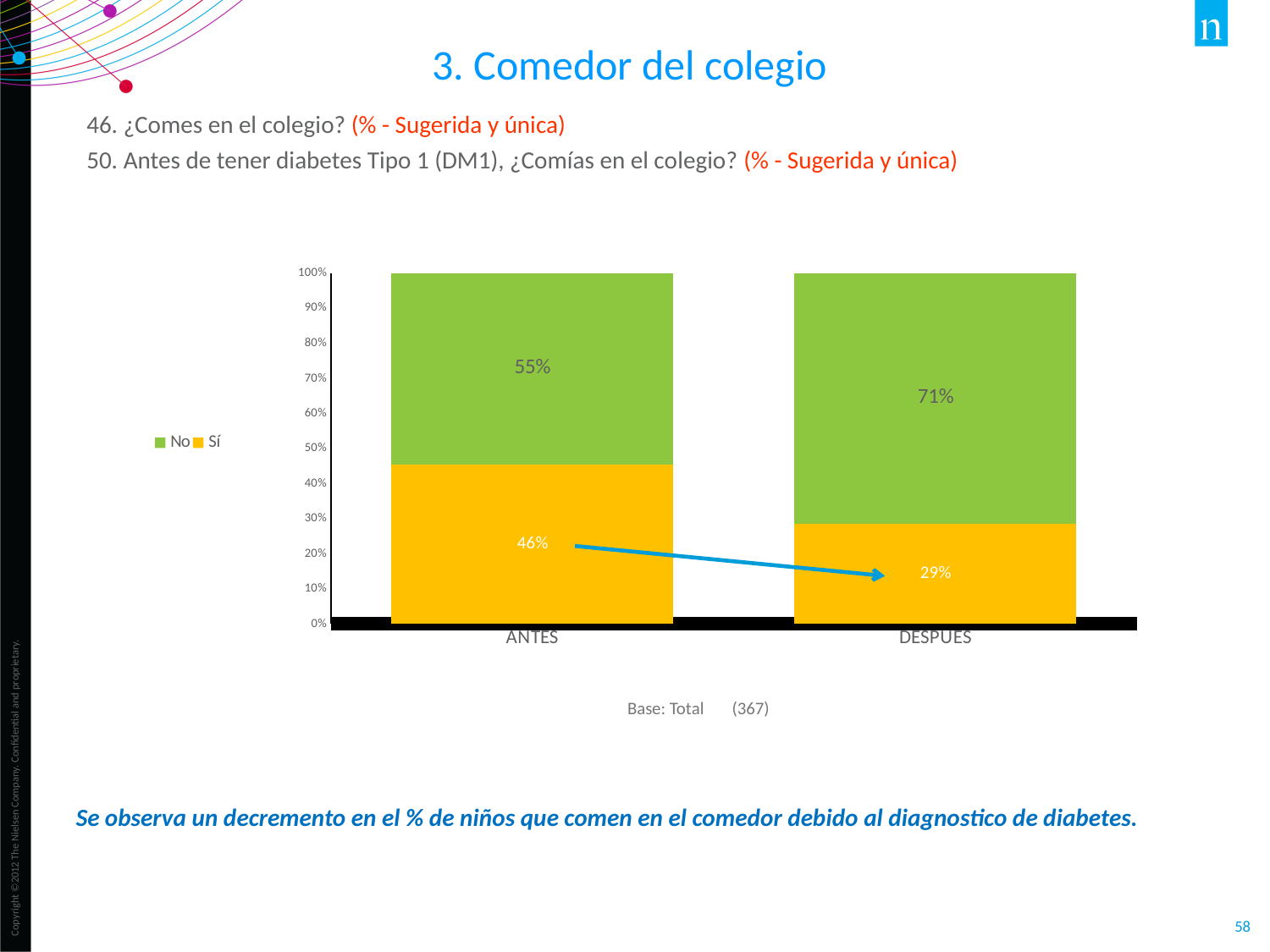
Does the "Sí" value rise or fall from ANTES to DESPUES? Fall How many categories are shown on the x axis? 2 Which category has the higher value for "Sí", ANTES or DESPUES? ANTES What is the value for "No" in the ANTES bar? 55% What is the difference between the "Sí" values for ANTES and DESPUES? 17% How many series does the legend list? 2 What is the difference between the "No" values for DESPUES and ANTES? 16% What is the value for "No" in the DESPUES bar? 71% What is the value for "Sí" in the ANTES bar? 46% What is the value for "Sí" in the DESPUES bar? 29% Which category has the highest value for "No"? DESPUES What kind of chart is shown on the slide? Stacked bar chart